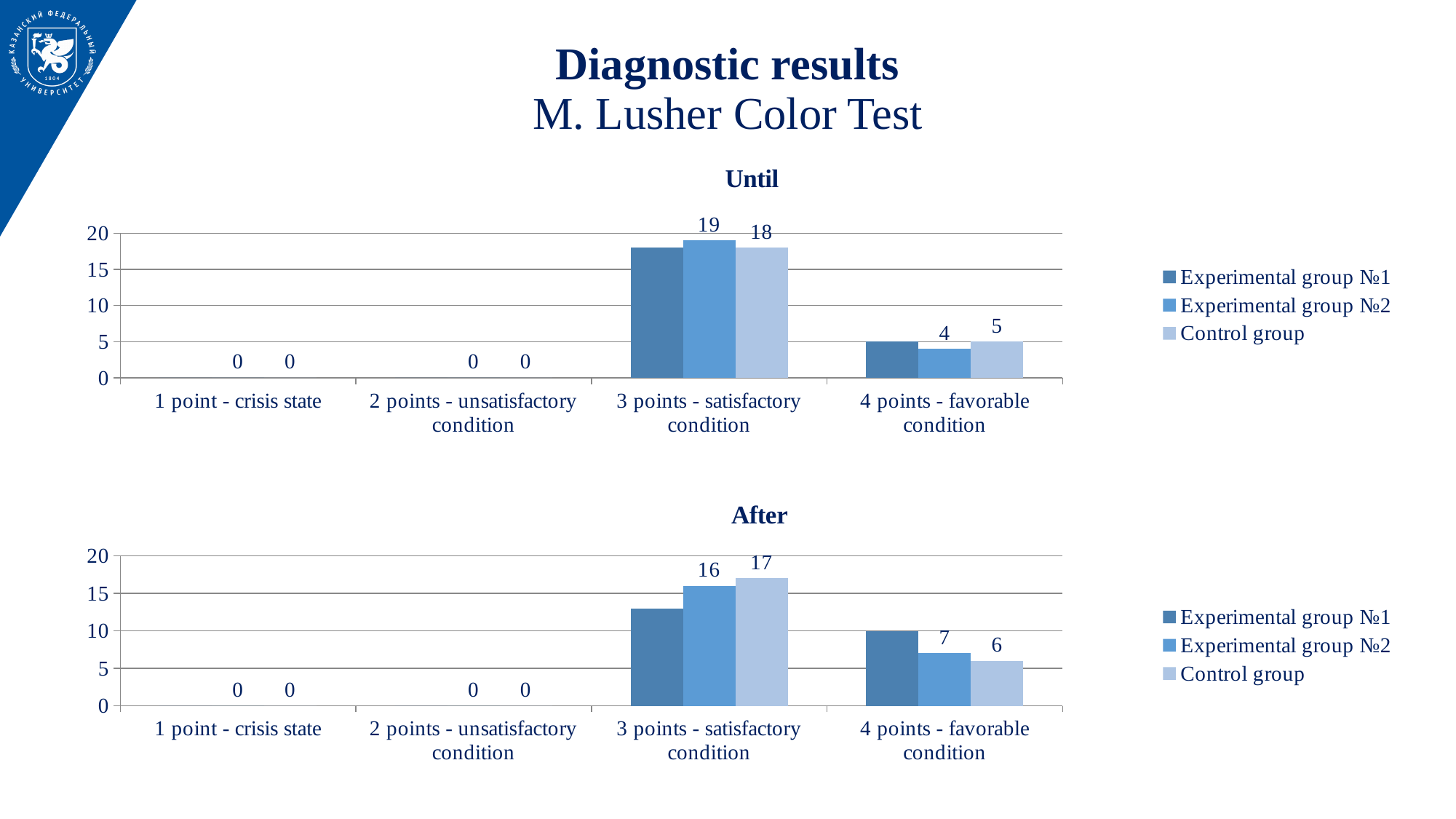
In the "Until" chart, is the value for Experimental group №1 at "3 points - satisfactory condition" greater or less than 15? greater How many series does the legend of the "Until" chart list? 3 How many categories are shown on the x axis of the "After" chart? 4 What kind of chart is the "After" chart? bar chart In the "After" chart, is the value for Experimental group №1 at "3 points - satisfactory condition" greater or less than 10? greater In the "Until" chart, what is the value for the Control group at "4 points - favorable condition"? 5 In the "After" chart, what is the value for Experimental group №2 at "4 points - favorable condition"? 7 In the "Until" chart, what is the difference between Experimental group №2 and the Control group at "3 points - satisfactory condition"? 1 In the "After" chart, what is the value for the Control group at "3 points - satisfactory condition"? 17 In the "Until" chart, what is the value for Experimental group №2 at "3 points - satisfactory condition"? 19 In the "After" chart, which is larger at "4 points - favorable condition": Experimental group №2 or the Control group? Experimental group №2 In the "Until" chart, which category has the highest value for Experimental group №2? 3 points - satisfactory condition